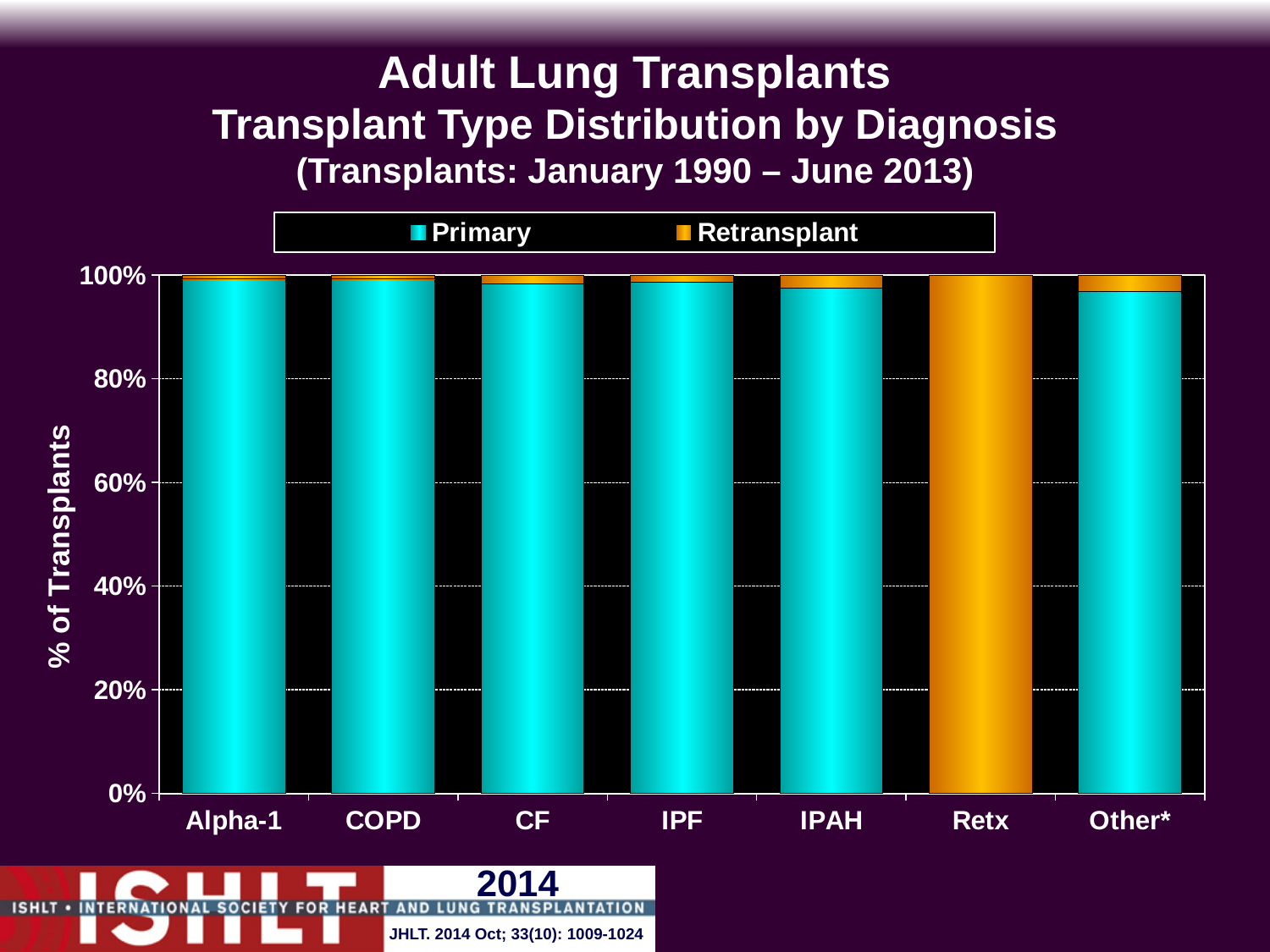
What is the label on the y axis? % of Transplants Which diagnosis category has the highest Retransplant share? Retx What are the two series named in the legend? Primary and Retransplant Is the Retransplant share for COPD greater or less than 20%? less Is the Primary share for Alpha-1 greater or less than 80%? greater Which has the larger Primary share, COPD or Retx? COPD How many series does the legend list? 2 Is the Retransplant share for Retx greater or less than 80%? greater What is the total height of the stacked bar for Alpha-1? 100% Which diagnosis category has the lowest Primary share? Retx What kind of chart is shown on the slide? stacked bar chart How many diagnosis categories are shown on the x axis? 7